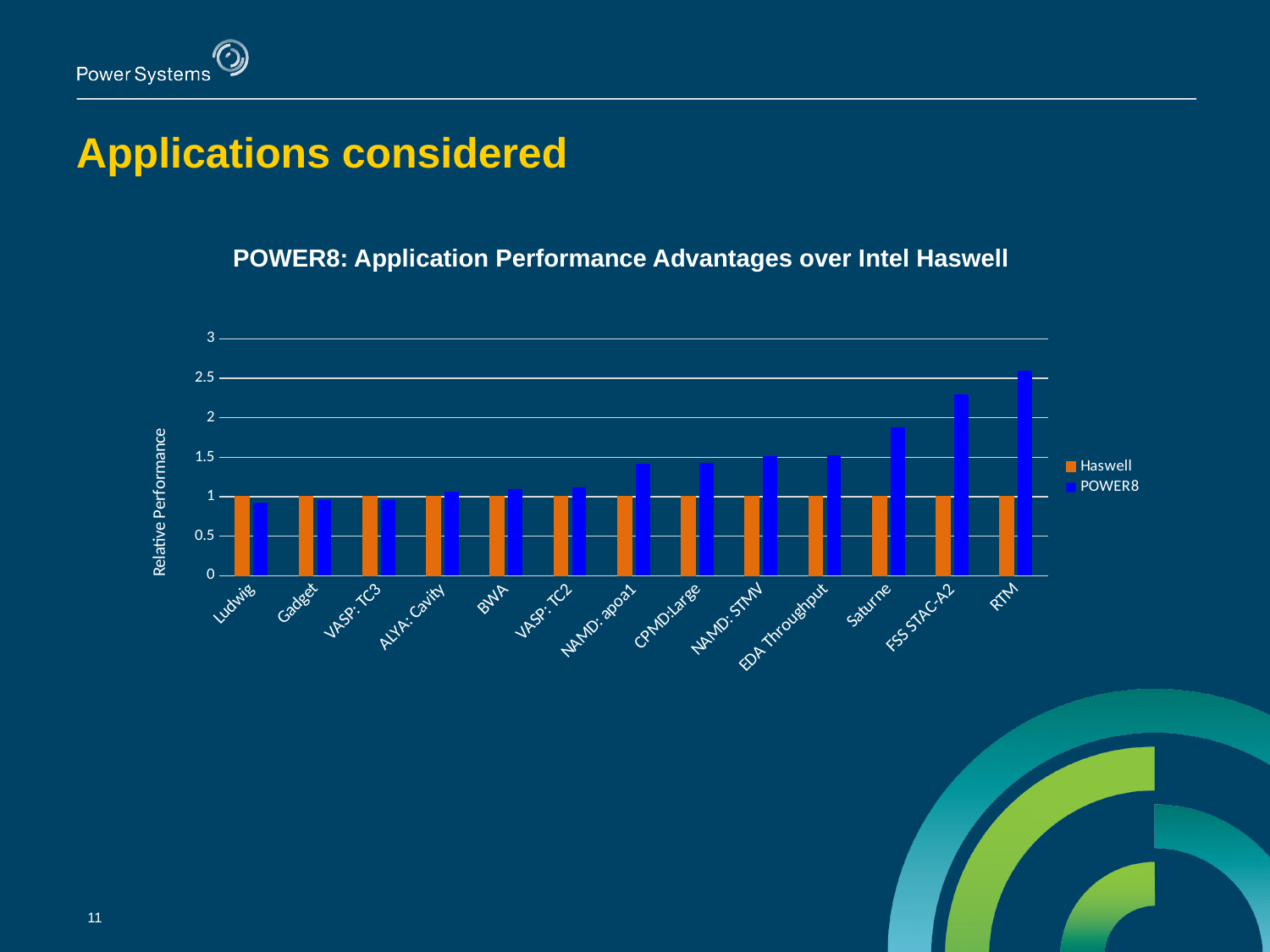
Is the POWER8 value for Ludwig greater or less than 1? less Which application has the highest POWER8 relative performance? RTM Is the POWER8 value for FSS STAC-A2 greater or less than 2? greater Is the POWER8 value for RTM greater or less than 2.5? greater How many series does the legend list? 2 What is the Haswell relative performance value for Ludwig? 1 Which has the larger POWER8 value, RTM or FSS STAC-A2? RTM What is the title of the chart? POWER8: Application Performance Advantages over Intel Haswell Do the POWER8 values generally rise or fall moving left to right along the x axis? rise What type of chart is shown on the slide? bar chart How many applications (categories) are shown on the x axis? 13